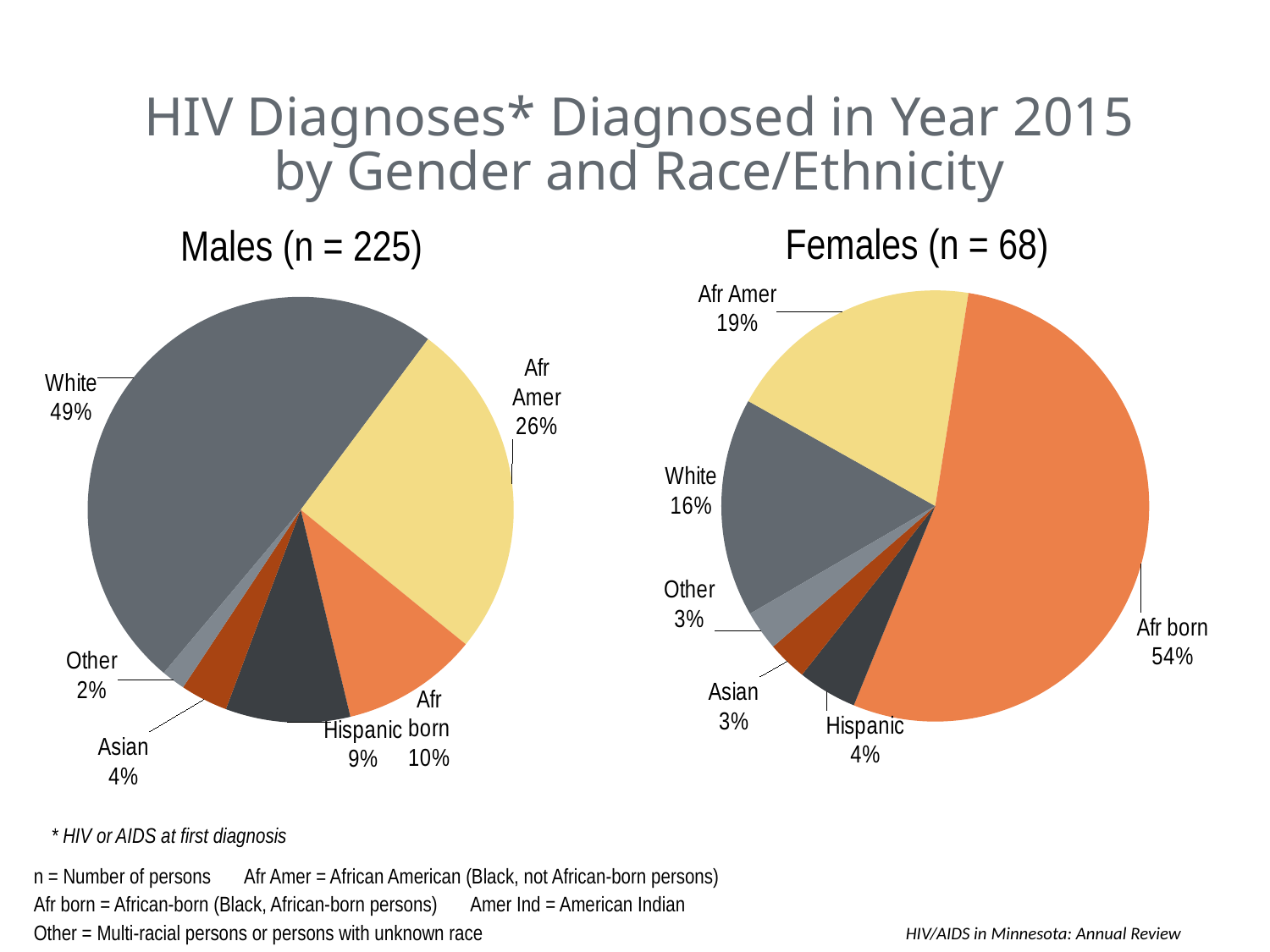
In the Males (n = 225) chart, what percentage is shown for Hispanic? 9% What type of chart is used for the Males (n = 225) data? Pie chart In the Females (n = 68) chart, which is larger, the White slice or the Afr Amer slice? Afr Amer In the Males (n = 225) chart, which race/ethnicity has the largest slice? White In the Males (n = 225) chart, which race/ethnicity has the smallest slice? Other In the Females (n = 68) chart, what share of HIV diagnoses is Afr born? 54% In the Females (n = 68) chart, what is the difference in percentage points between Afr born and White? 38 How many slices does the Females (n = 68) pie chart have? 6 In the Males (n = 225) chart, what is the difference in percentage points between White and Afr Amer? 23 In the Females (n = 68) chart, which race/ethnicity has the largest slice? Afr born In the Males (n = 225) chart, what share of HIV diagnoses is White? 49% In the Females (n = 68) chart, what percentage is shown for Afr Amer? 19%